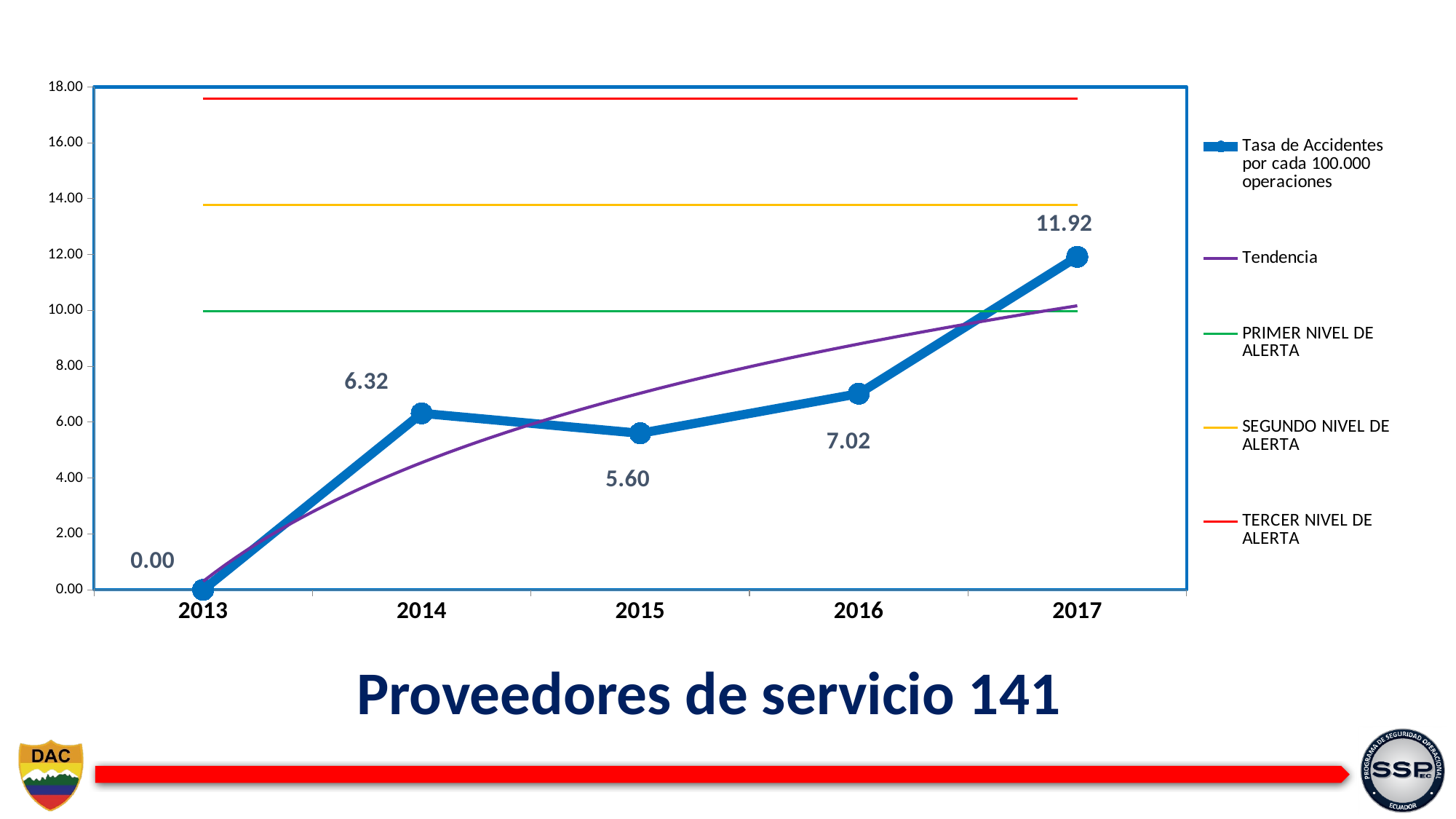
What is the Tasa de Accidentes por cada 100.000 operaciones value for 2017? 11.92 Which year has the lowest Tasa de Accidentes por cada 100.000 operaciones? 2013 Which year has a higher Tasa de Accidentes value, 2014 or 2015? 2014 How many series does the legend list? 5 What is the title shown below the chart? Proveedores de servicio 141 What is the difference between the Tasa de Accidentes values for 2017 and 2016? 4.90 What is the Tasa de Accidentes por cada 100.000 operaciones value for 2014? 6.32 Is the Tasa de Accidentes value for 2017 greater or less than 10.00? greater What kind of chart is shown on the slide? line chart What is the Tasa de Accidentes por cada 100.000 operaciones value for 2013? 0.00 Which year has the highest Tasa de Accidentes por cada 100.000 operaciones? 2017 How many years are shown on the x axis? 5